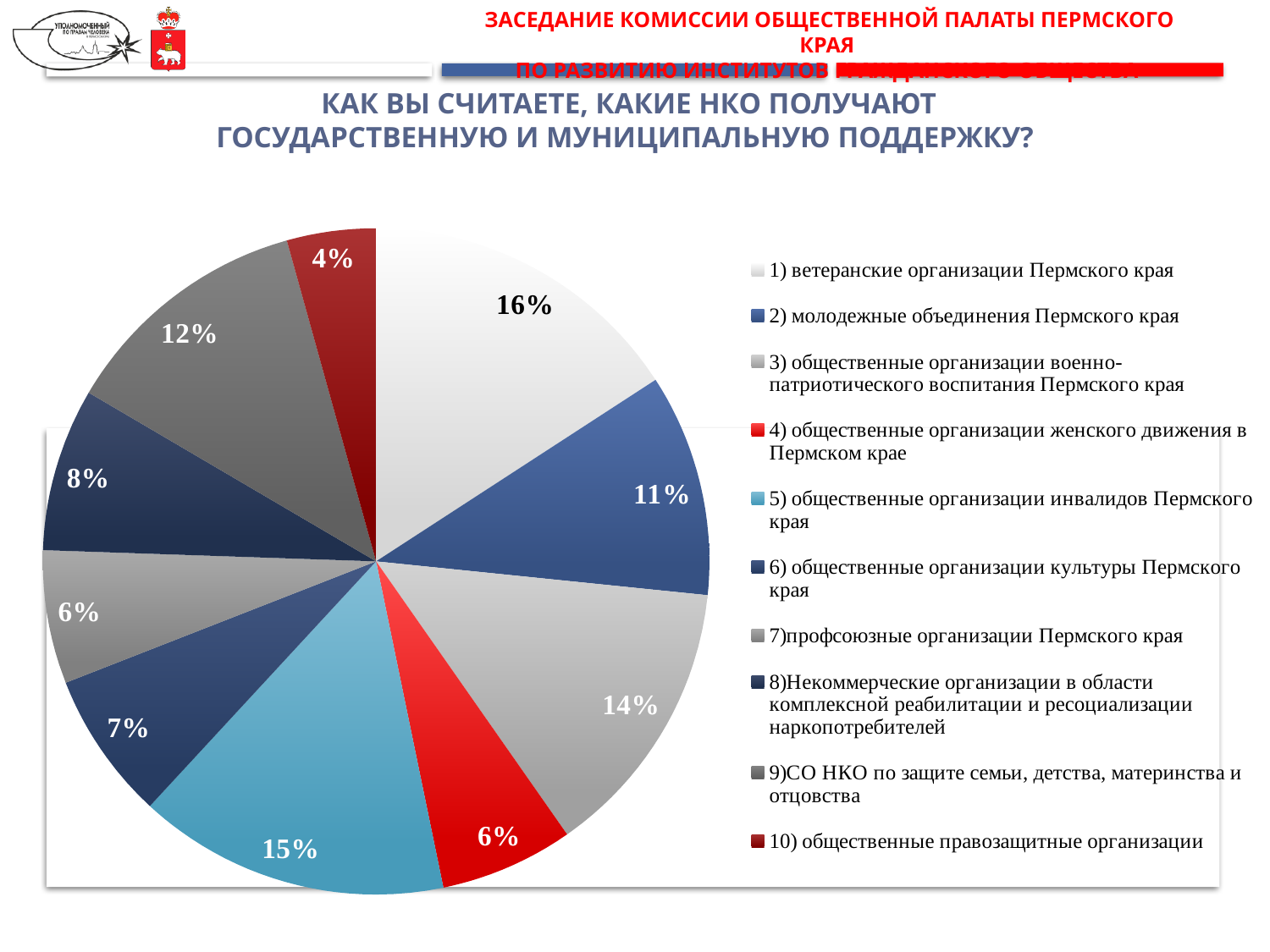
What share of the pie is labelled for 2) молодежные объединения Пермского края? 11% How many entries does the legend list? 10 What share of the pie is labelled for 9) СО НКО по защите семьи, детства, материнства и отцовства? 12% Which is larger: the slice for 8) Некоммерческие организации в области комплексной реабилитации и ресоциализации наркопотребителей or the slice for 6) общественные организации культуры Пермского края? 8) Некоммерческие организации в области комплексной реабилитации и ресоциализации наркопотребителей Which category has the largest slice of the pie? 1) ветеранские организации Пермского края Which category has the smallest slice of the pie? 10) общественные правозащитные организации How many slices does the pie chart have? 10 What share of the pie is labelled for 1) ветеранские организации Пермского края? 16% What kind of chart is shown on the slide? pie chart What share of the pie is labelled for 5) общественные организации инвалидов Пермского края? 15% What is the difference in percentage points between the slice for 3) общественные организации военно-патриотического воспитания Пермского края and the slice for 4) общественные организации женского движения в Пермском крае? 8 What colour is the slice for 4) общественные организации женского движения в Пермском крае? red